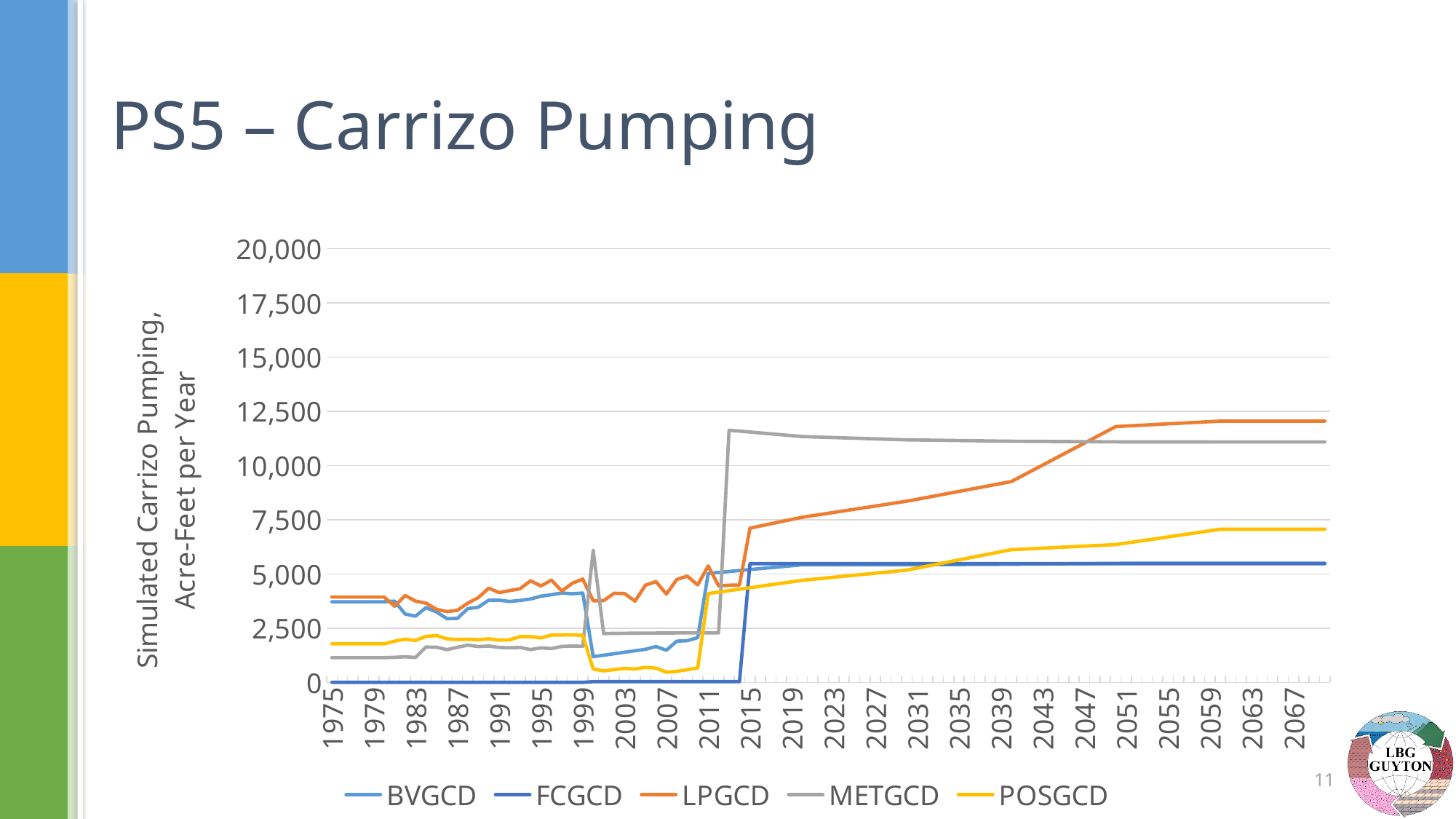
What is the label on the vertical axis? Simulated Carrizo Pumping, Acre-Feet per Year What kind of chart is shown on the slide? line chart How many series does the legend list? 5 Does the LPGCD series rise or fall between 2015 and 2051? rise Is the value for POSGCD in 2067 greater or less than 7,500? less Which series has the highest value at the right end of the chart (2067)? LPGCD What is the title of the slide? PS5 – Carrizo Pumping In 2067, which is larger: FCGCD or POSGCD? POSGCD Which series has the lowest value in 1975? FCGCD Is the value for FCGCD in 2067 greater or less than 5,000? greater Is the value for LPGCD in 2067 greater or less than 10,000? greater